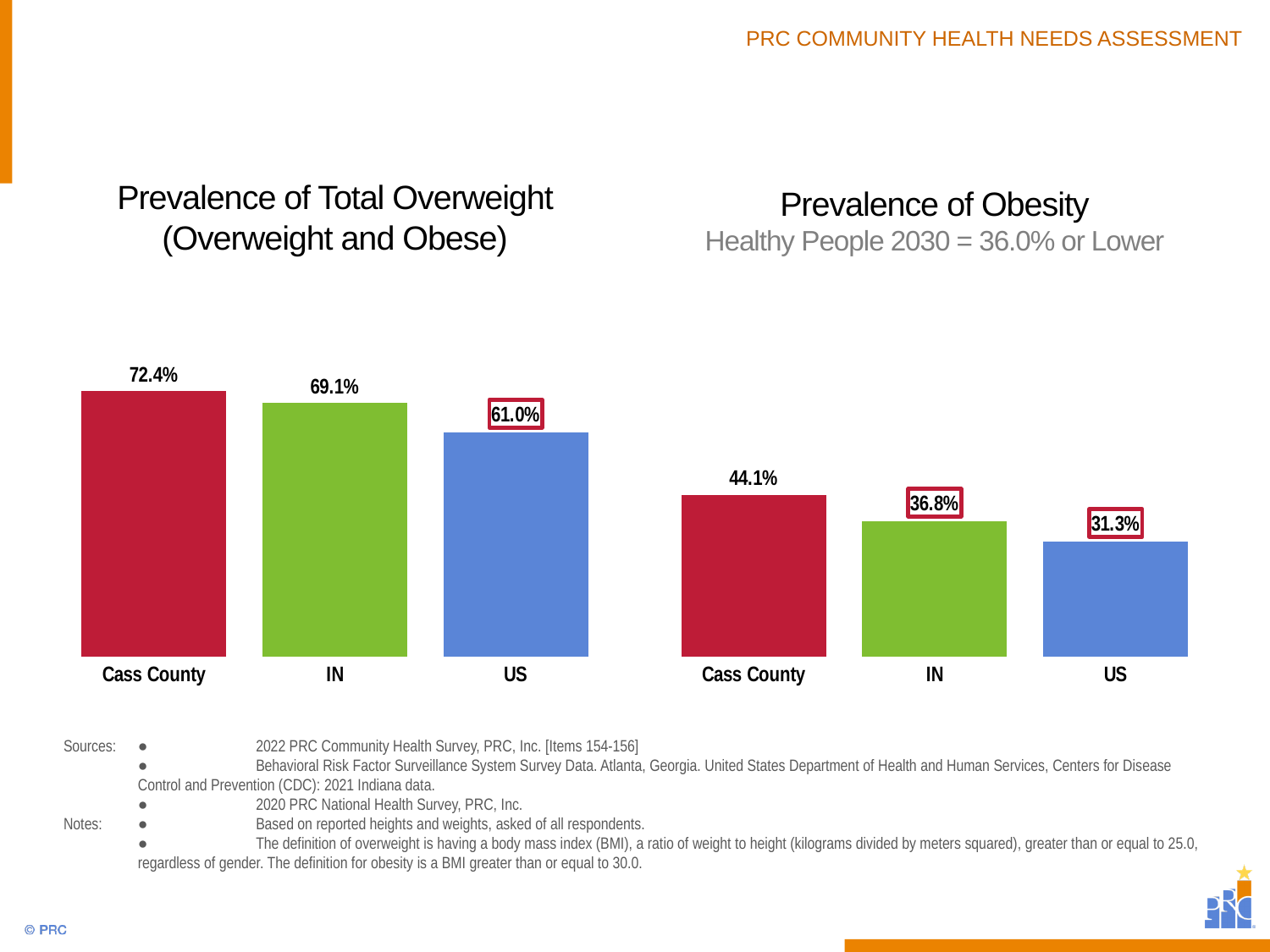
In the 'Prevalence of Obesity' chart, what is the value for US? 31.3% In the 'Prevalence of Obesity' chart, which category has the highest value? Cass County In the 'Prevalence of Total Overweight (Overweight and Obese)' chart, what is the value for Cass County? 72.4% In the 'Prevalence of Total Overweight (Overweight and Obese)' chart, what is the difference between the Cass County and US values? 11.4% What type of chart is the 'Prevalence of Obesity' chart? Bar chart In the 'Prevalence of Obesity' chart, what is the value for Cass County? 44.1% In the 'Prevalence of Total Overweight (Overweight and Obese)' chart, which category has the lowest value? US In the 'Prevalence of Obesity' chart, how many categories are shown? 3 In the 'Prevalence of Obesity' chart, what is the difference between the Cass County and IN values? 7.3% In the 'Prevalence of Total Overweight (Overweight and Obese)' chart, what is the value for IN? 69.1% In the 'Prevalence of Total Overweight (Overweight and Obese)' chart, what is the value for US? 61.0% In the 'Prevalence of Obesity' chart, what is the value for IN? 36.8%